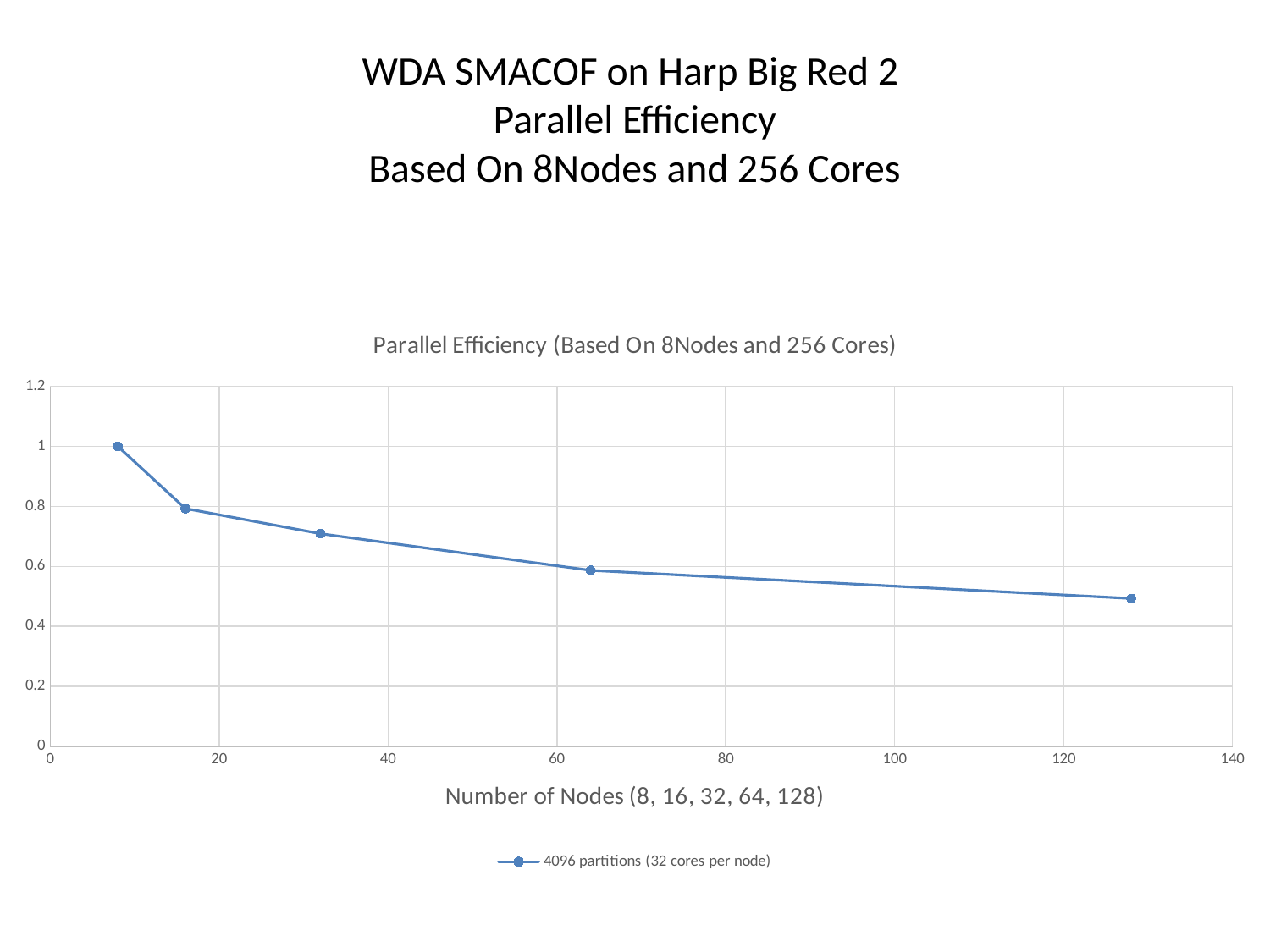
Do the parallel efficiency values rise or fall as the number of nodes increases? fall Is the parallel efficiency at 128 nodes greater or less than 0.6? less What kind of chart is shown on the slide? line chart How many series does the legend list? 1 Is the parallel efficiency at 32 nodes greater or less than 0.8? less What series name is shown in the chart legend? 4096 partitions (32 cores per node) At which number of nodes is the parallel efficiency lowest? 128 How many data points are plotted on the line? 5 What is the parallel efficiency at 8 nodes? 1 Is the parallel efficiency at 64 nodes greater or less than 0.4? greater Which has the larger parallel efficiency, 16 nodes or 64 nodes? 16 nodes At which number of nodes is the parallel efficiency highest? 8